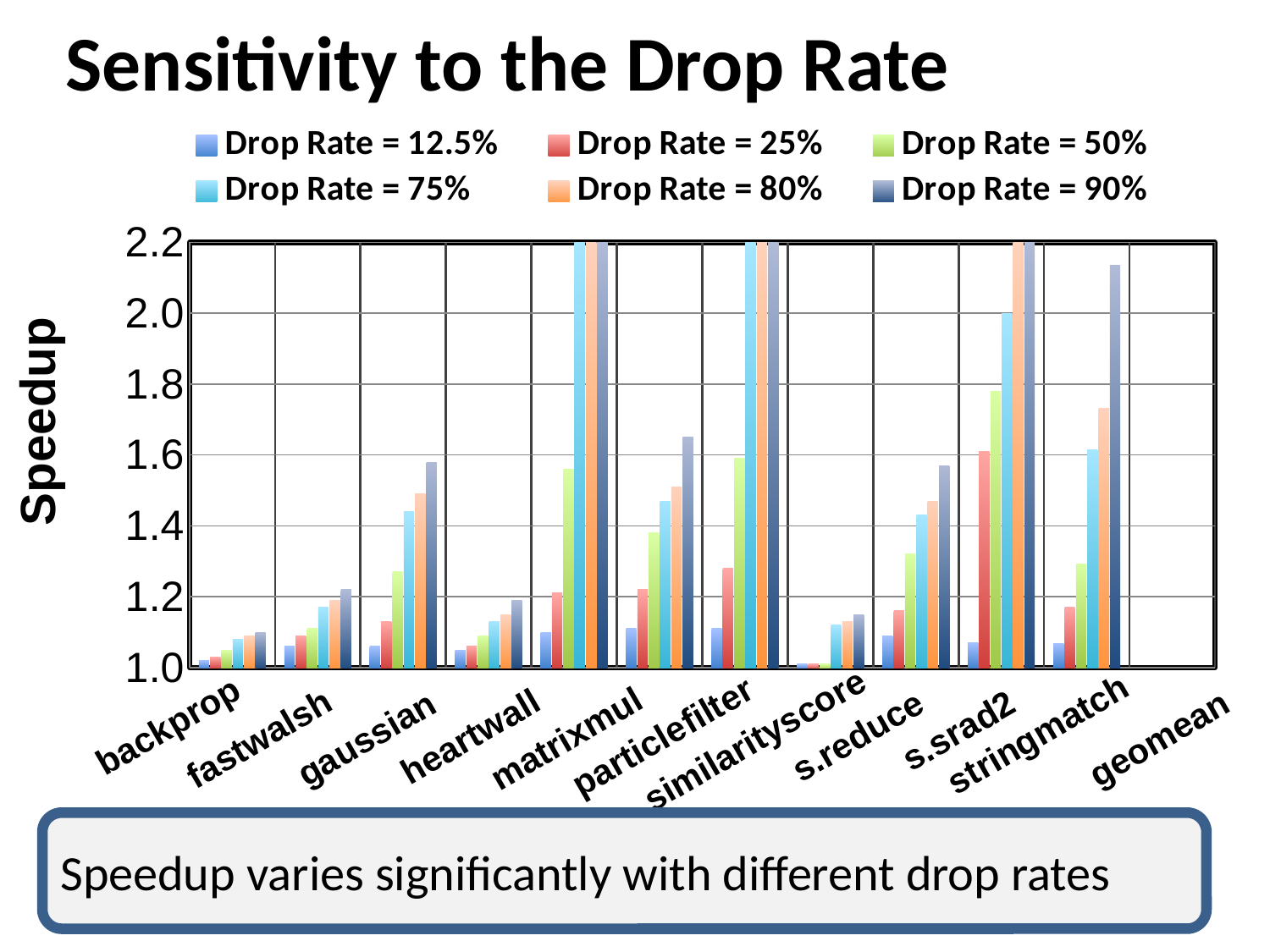
What is the label on the y axis? Speedup Is the value for stringmatch at Drop Rate = 90% greater or less than 2.0? greater Is the value for particlefilter at Drop Rate = 25% greater or less than 1.4? less For gaussian, which is larger: the Drop Rate = 75% bar or the Drop Rate = 12.5% bar? Drop Rate = 75% How many categories are labelled along the x axis? 11 What is the title of the chart? Sensitivity to the Drop Rate What kind of chart is shown on the slide? bar chart Is the value for backprop at Drop Rate = 90% greater or less than 1.2? less How many series does the legend list? 6